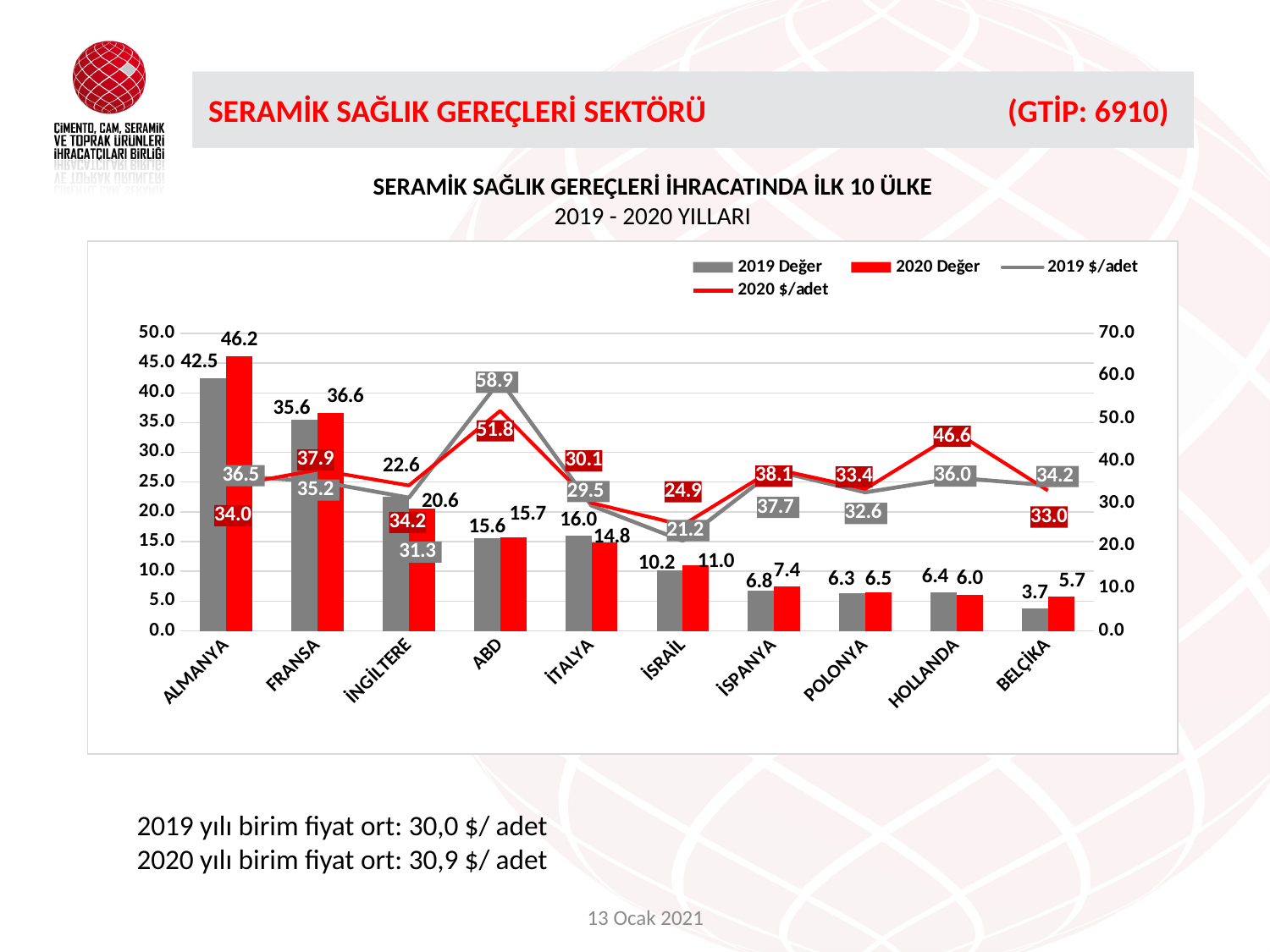
Which country has the highest 2020 Değer value? ALMANYA How many series does the legend list? 4 What kind of chart is this? Combined bar and line chart What is the 2020 Değer value for ALMANYA? 46.2 Which is larger for İTALYA: the 2019 Değer value or the 2020 Değer value? 2019 Değer What is the 2019 Değer value for İNGİLTERE? 22.6 Do the 2019 Değer bar values generally rise or fall from ALMANYA to BELÇİKA? Fall What is the difference between the 2020 Değer and 2019 Değer values for ALMANYA? 3.7 What is the 2020 $/adet value for HOLLANDA? 46.6 Which country has the lowest 2019 Değer value? BELÇİKA What is the 2019 $/adet value for ABD? 58.9 How many countries are shown on the x axis? 10